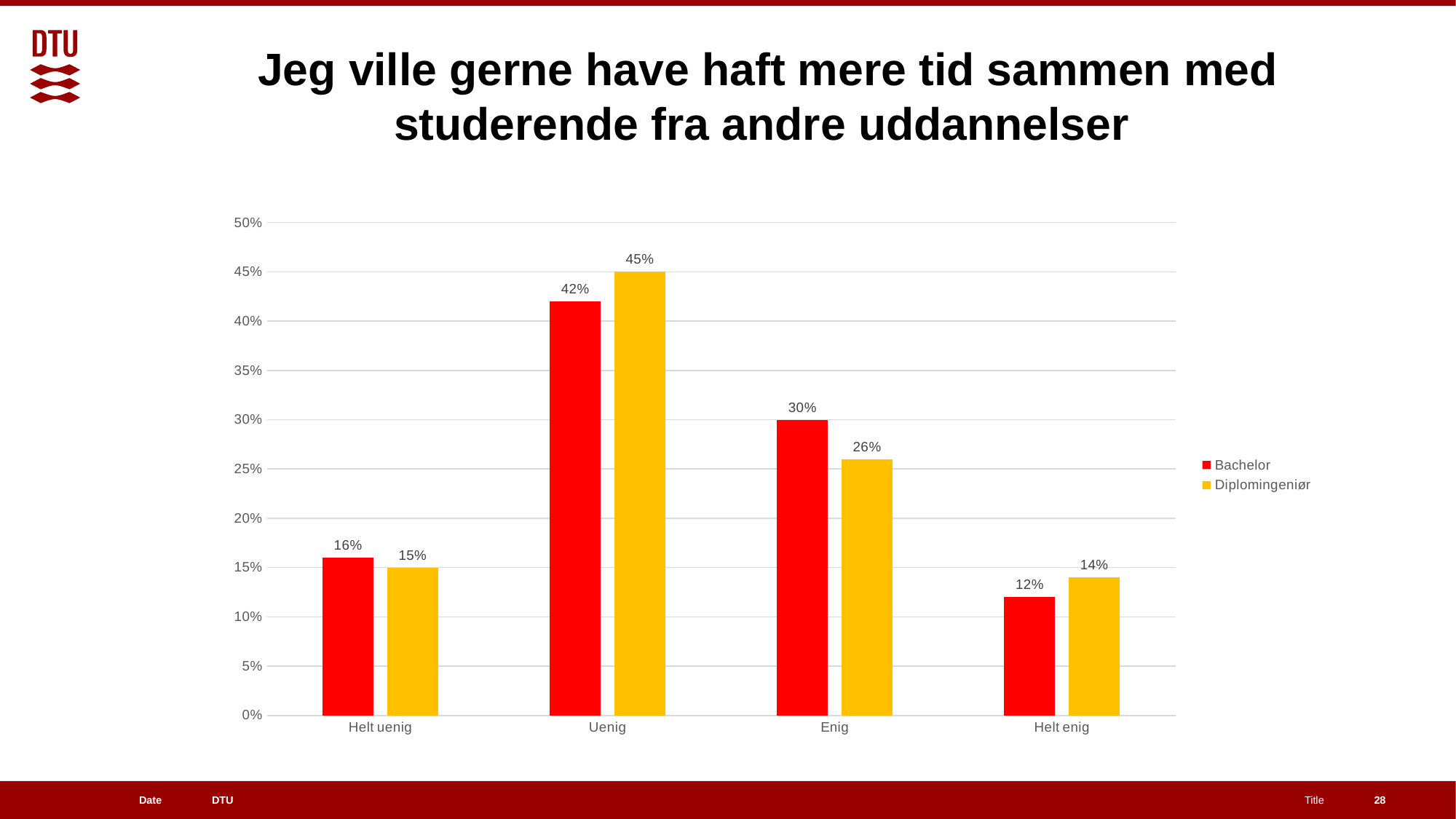
What is the Bachelor value for Uenig? 42% How many categories are shown on the x axis? 4 Which category has the lowest Diplomingeniør value? Helt enig What kind of chart is shown on the slide? Bar chart For Uenig, which series has the larger value, Bachelor or Diplomingeniør? Diplomingeniør How many series does the legend list? 2 Which colour represents the Bachelor series? Red What is the difference between the Bachelor and Diplomingeniør values for Enig? 4% What is the Diplomingeniør value for Enig? 26% Is the Bachelor value for Helt uenig greater or less than 20%? less What is the Diplomingeniør value for Helt enig? 14% Which category has the highest Bachelor value? Uenig